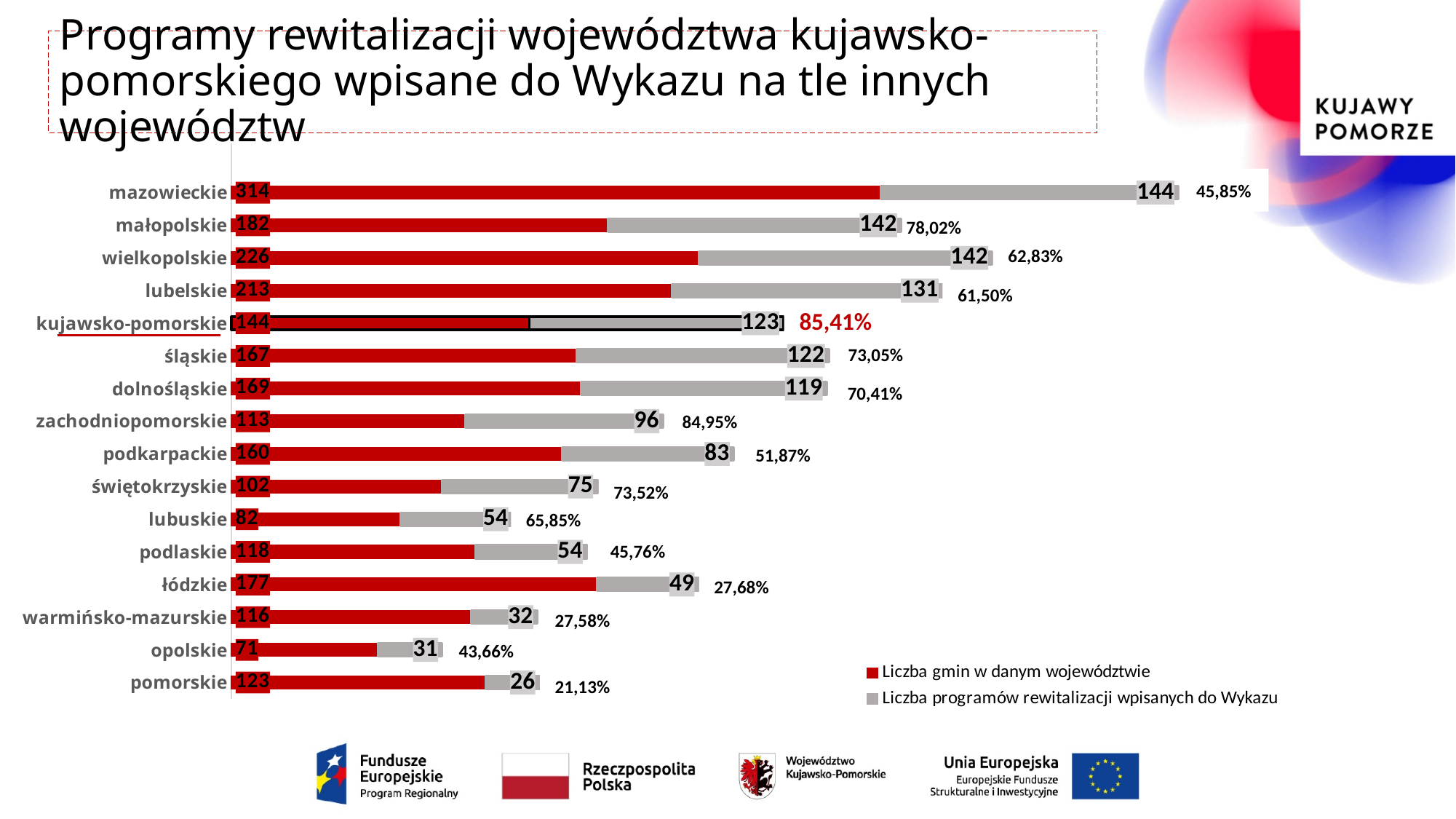
What kind of chart is shown on the slide? bar chart Which has more gminas, wielkopolskie or lubelskie? wielkopolskie How many revitalisation programmes entered in the Wykaz are shown for kujawsko-pomorskie? 123 What is the difference between the number of gminas in mazowieckie and in małopolskie? 132 Which voivodeship has the lowest number of revitalisation programmes entered in the Wykaz? pomorskie How many voivodeships are listed on the chart? 16 How many series does the legend list? 2 Which voivodeship has the lowest number of gminas (red series)? opolskie How many gminas (Liczba gmin w danym województwie) are shown for mazowieckie? 314 Which voivodeship has the highest number of revitalisation programmes entered in the Wykaz? mazowieckie What percentage is shown next to the bar for kujawsko-pomorskie? 85,41% What is the total of the stacked bar for kujawsko-pomorskie (gminas plus programmes)? 267